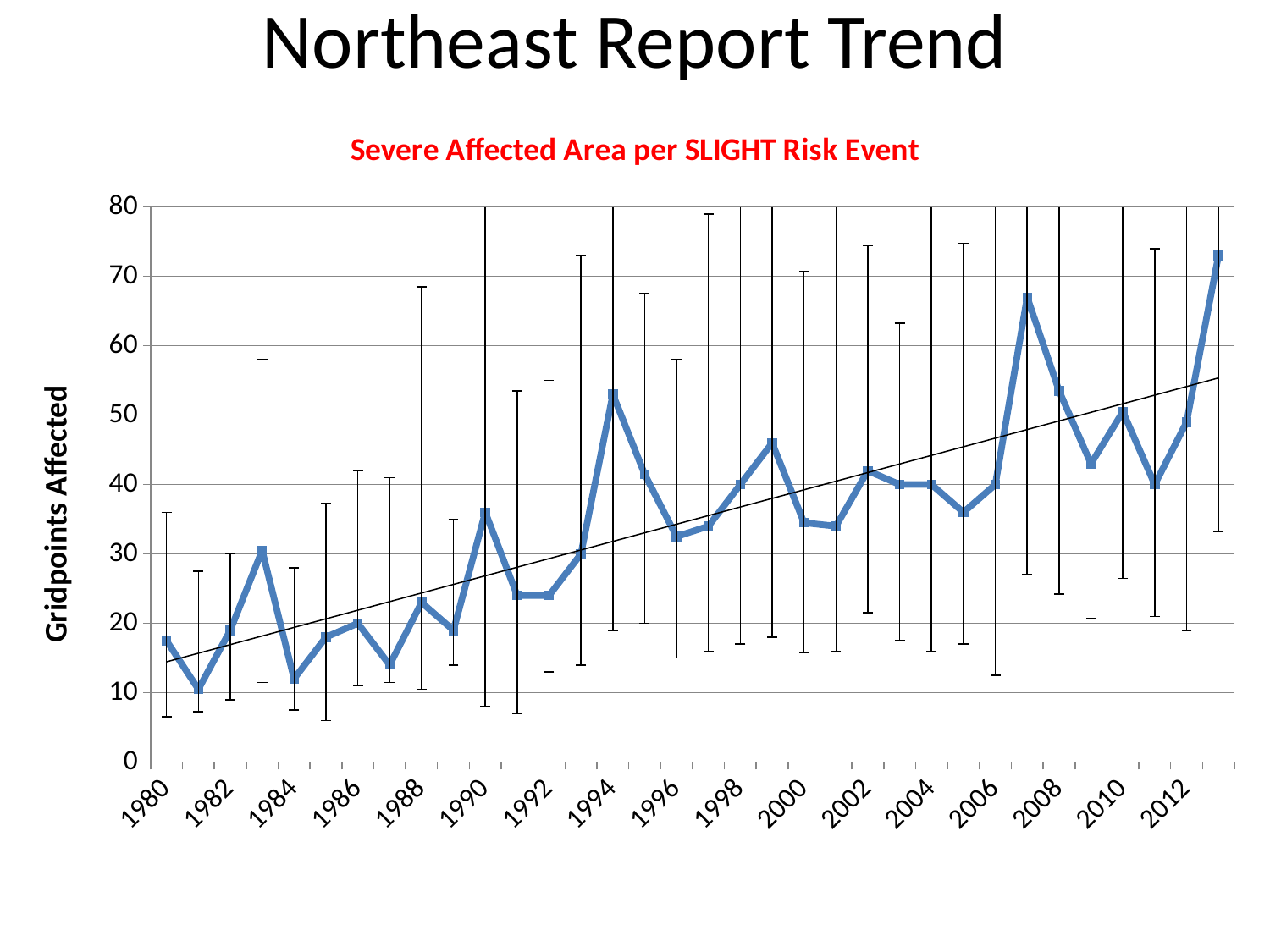
Overall, do the values rise or fall from 1980 to 2013? Rise Is the value for 1994 greater or less than 50? greater Which year has the highest value of gridpoints affected? 2013 Is the value for 2007 greater or less than 60? greater What kind of chart is shown on the slide? Line chart What is the title of the chart? Severe Affected Area per SLIGHT Risk Event Which year has the larger value, 2007 or 1994? 2007 What is the label on the vertical axis of the chart? Gridpoints Affected Is the value for 1981 greater or less than 20? less Which year has the larger value, 1983 or 1984? 1983